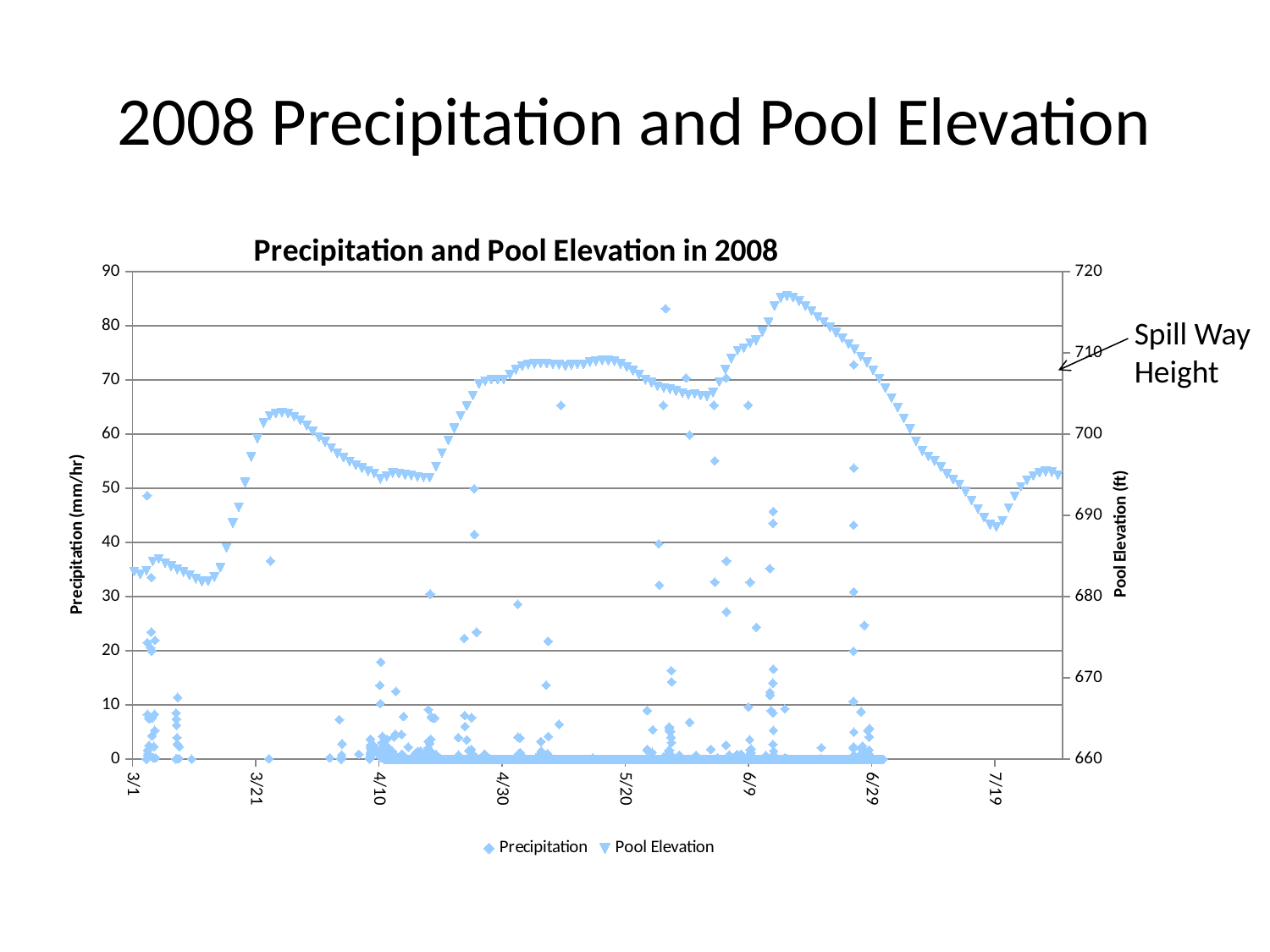
Is the highest Precipitation value plotted (around late May) greater or less than 70 mm/hr? greater Does the Pool Elevation rise or fall between 6/29 and 7/19? fall What kind of chart is shown on the slide? scatter chart What is the title of the chart? Precipitation and Pool Elevation in 2008 Is the Pool Elevation value on 3/1 greater or less than 690 ft? less What are the two series named in the legend? Precipitation and Pool Elevation What is the maximum value shown on the right-hand Pool Elevation axis? 720 Does the Pool Elevation rise or fall between 3/1 and 3/21? rise How many date labels are shown on the x axis? 8 Is the peak Pool Elevation value reached in mid-June greater or less than 710 ft? greater How many series does the legend list? 2